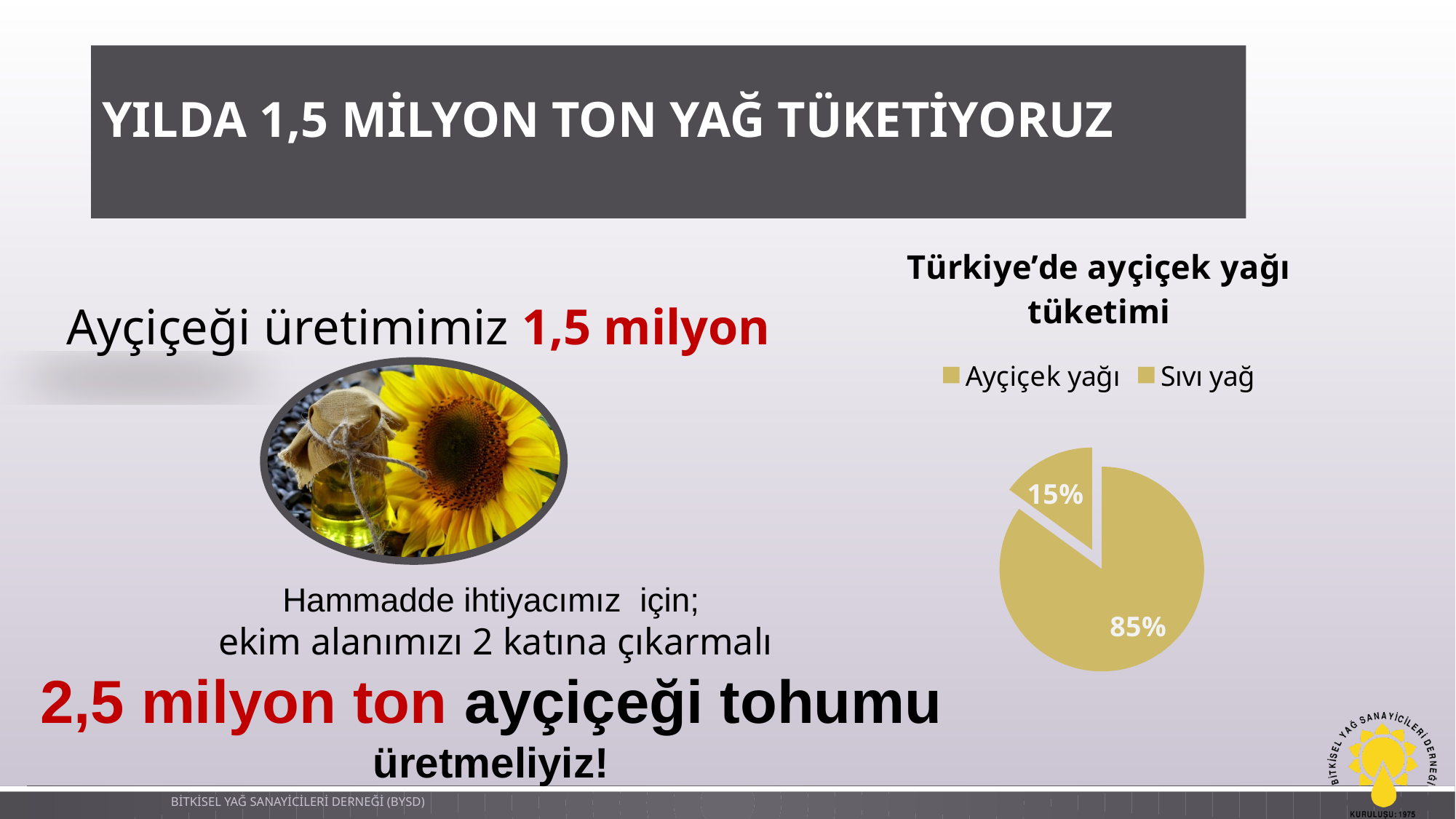
How many slices does the pie chart have? 2 What share does Sıvı yağ have in the pie chart? 15% What is the share of the largest slice in the pie chart? 85% How many entries does the chart legend list? 2 What is the title of the chart? Türkiye'de ayçiçek yağı tüketimi What is the difference in percentage points between the two slices of the pie chart? 70 What kind of chart is shown on the slide? pie chart What share does Ayçiçek yağı have in the pie chart? 85% Is the share of the smaller slice greater or less than 50%? less Which legend entry is listed first in the chart legend? Ayçiçek yağı Which slice is larger, Ayçiçek yağı or Sıvı yağ? Ayçiçek yağı What is the share of the smallest slice in the pie chart? 15%